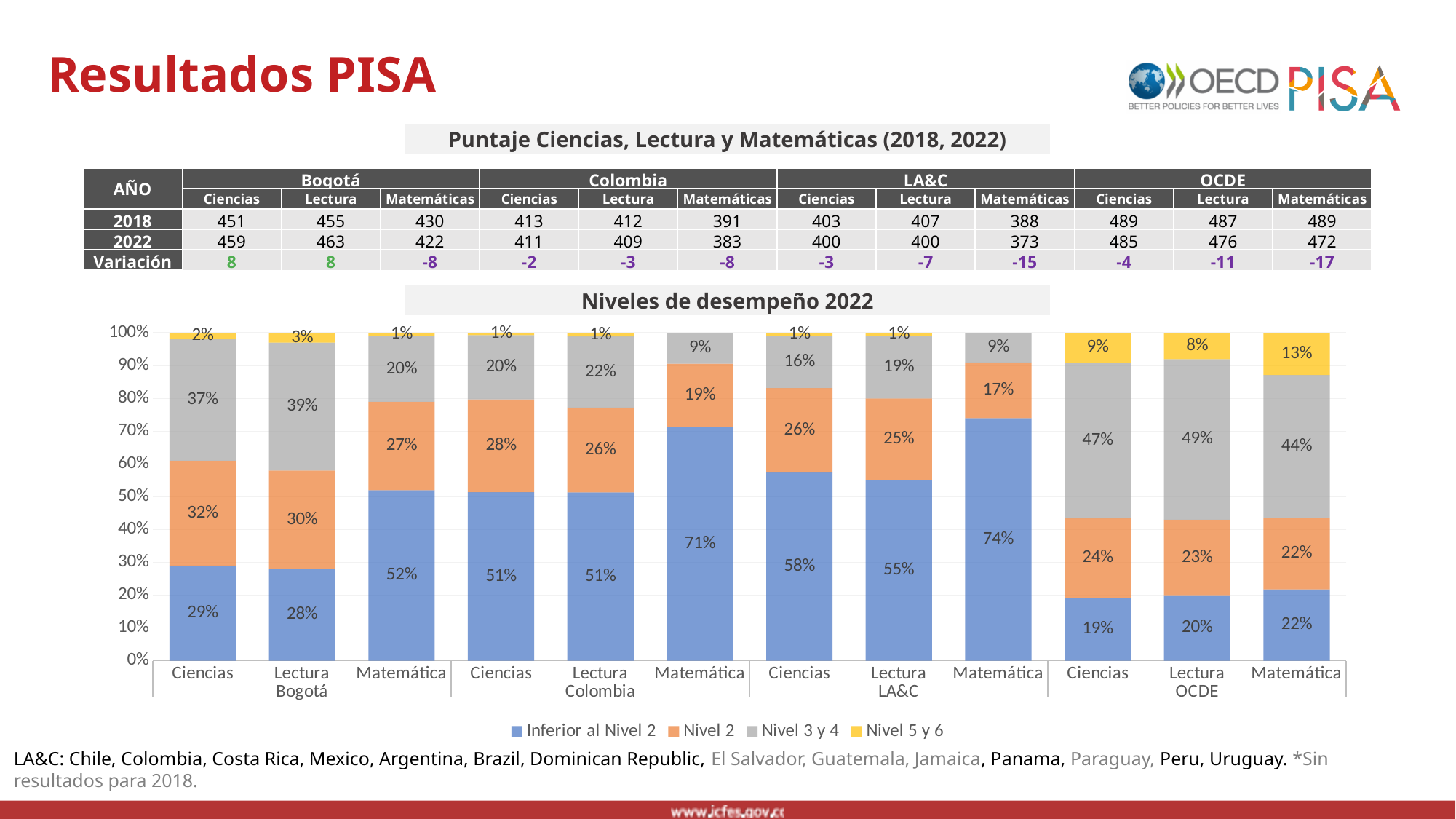
What kind of chart is 'Niveles de desempeño 2022'? Stacked bar chart In the 'Niveles de desempeño 2022' chart, what is the 'Nivel 3 y 4' share for Lectura in OCDE? 49% In the 'Niveles de desempeño 2022' chart, which bar has the highest 'Inferior al Nivel 2' share? Matemática LA&C How many bars are shown in the 'Niveles de desempeño 2022' chart? 12 In the 'Niveles de desempeño 2022' chart, is the 'Inferior al Nivel 2' share for Ciencias in LA&C greater or less than 50%? greater In the 'Niveles de desempeño 2022' chart, what is the 'Nivel 2' share for Ciencias in Bogotá? 32% How many series does the legend of the 'Niveles de desempeño 2022' chart list? 4 In the 'Niveles de desempeño 2022' chart, which bar has the lowest 'Inferior al Nivel 2' share? Ciencias OCDE In the 'Niveles de desempeño 2022' chart, what is the 'Inferior al Nivel 2' share for Matemática in LA&C? 74% In the 'Niveles de desempeño 2022' chart, what is the 'Nivel 5 y 6' share for Matemática in OCDE? 13% In the 'Niveles de desempeño 2022' chart, which is larger: the 'Nivel 3 y 4' share for Lectura in Bogotá or for Lectura in Colombia? Lectura Bogotá In the 'Niveles de desempeño 2022' chart, what is the difference between the 'Inferior al Nivel 2' share for Matemática in Colombia and for Matemática in OCDE? 49%